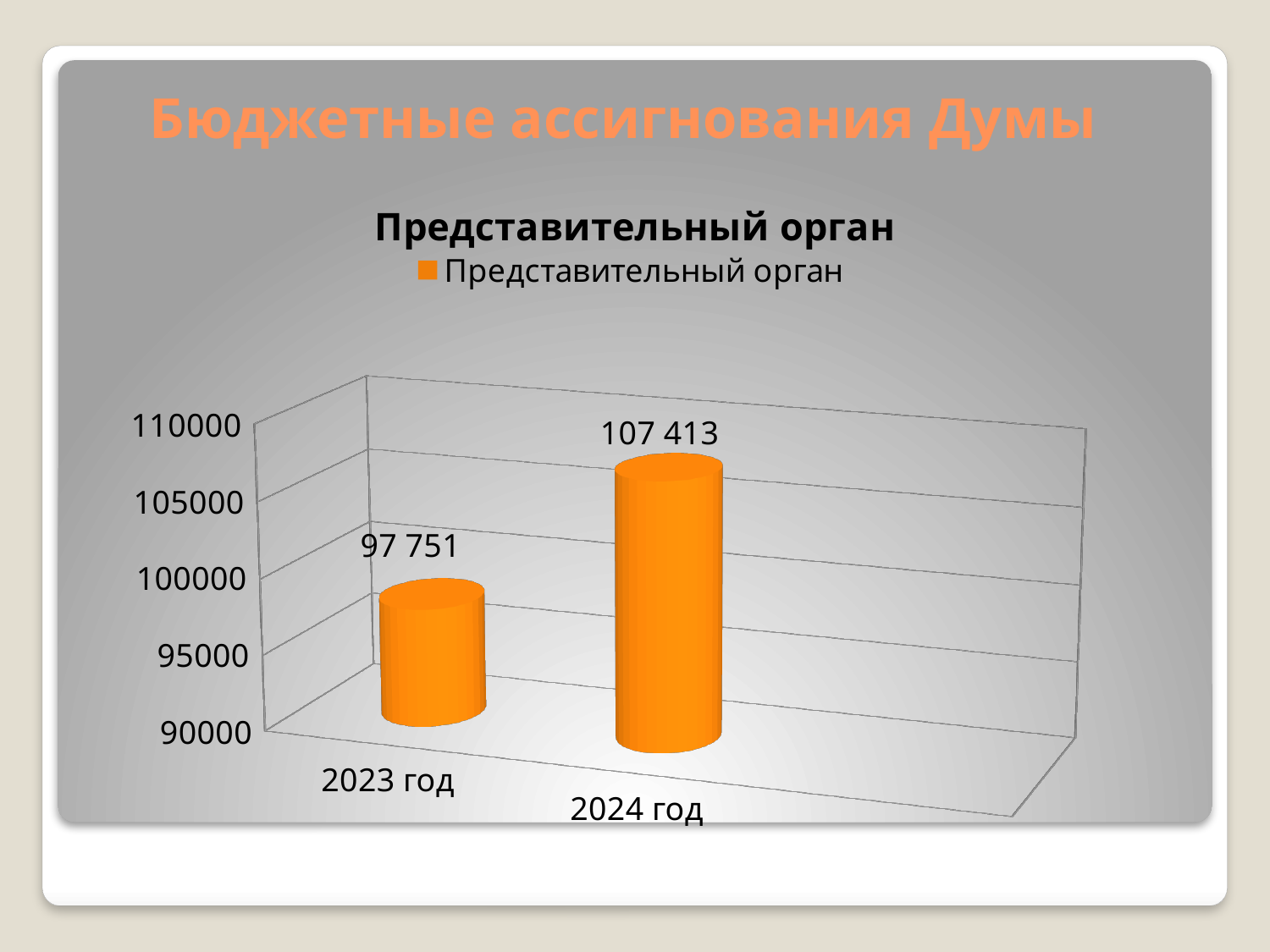
What kind of chart is shown? bar chart How many series does the legend list? 1 Do the values rise or fall from 2023 год to 2024 год? rise What is the difference between the values for 2024 год and 2023 год? 9 662 What is the title of the chart? Представительный орган Which year has the higher value? 2024 год Is the value for 2023 год greater or less than 100000? less What is the value for 2023 год? 97 751 How many categories are shown on the x axis? 2 Which year has the lower value? 2023 год Is the value for 2024 год greater or less than 105000? greater What is the value for 2024 год? 107 413